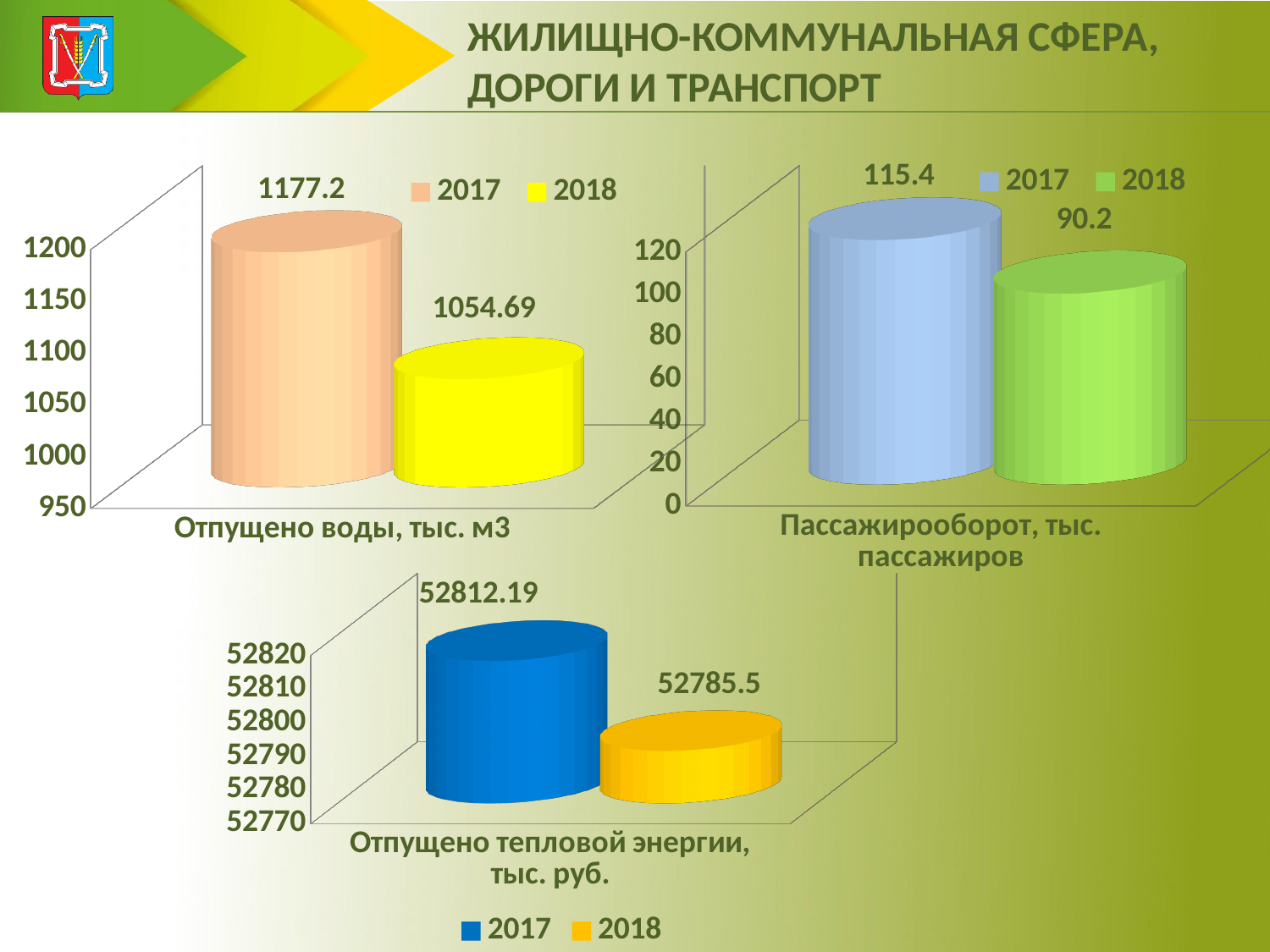
In the top-right chart (Пассажирооборот, тыс. пассажиров), what is the value for 2017? 115.4 In the bottom chart (Отпущено тепловой энергии, тыс. руб.), what is the value for 2018? 52785.5 In the top-right chart (Пассажирооборот, тыс. пассажиров), what is the value for 2018? 90.2 In the top-left chart (Отпущено воды, тыс. м3), what is the value for 2017? 1177.2 In the top-left chart (Отпущено воды, тыс. м3), what is the value for 2018? 1054.69 In the top-right chart (Пассажирооборот, тыс. пассажиров), what is the difference between the 2017 and 2018 values? 25.2 How many series does the legend of the bottom chart (Отпущено тепловой энергии, тыс. руб.) list? 2 What kind of chart is the top-left chart (Отпущено воды, тыс. м3)? bar chart In the bottom chart (Отпущено тепловой энергии, тыс. руб.), what is the value for 2017? 52812.19 In the top-left chart (Отпущено воды, тыс. м3), by how much does the 2017 value exceed the 2018 value? 122.51 In the bottom chart (Отпущено тепловой энергии, тыс. руб.), which year has the higher value, 2017 or 2018? 2017 In the top-right chart (Пассажирооборот, тыс. пассажиров), is the value for 2018 greater or less than 100? less